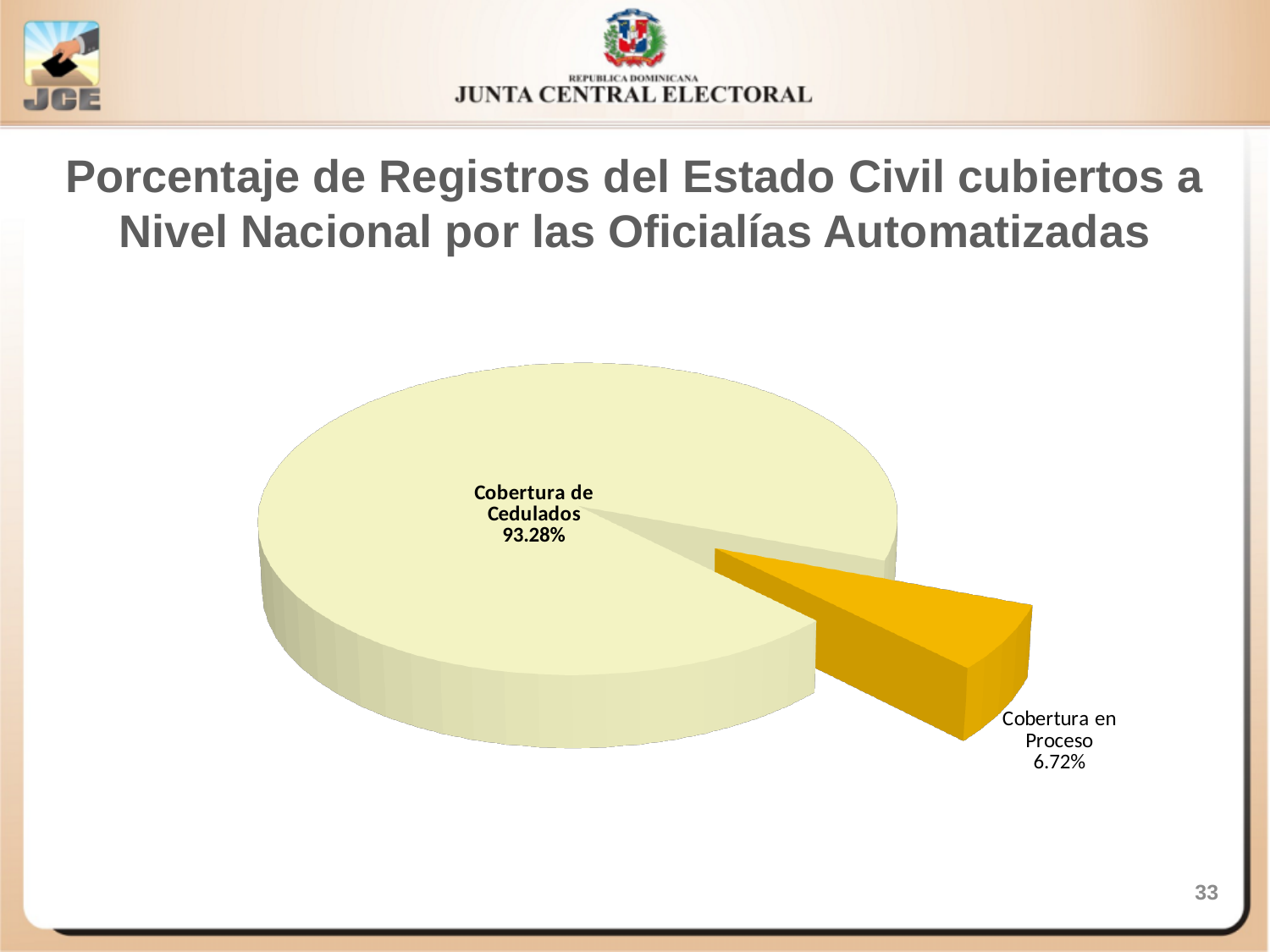
What is the title of the slide containing the pie chart? Porcentaje de Registros del Estado Civil cubiertos a Nivel Nacional por las Oficialías Automatizadas What colour is the Cobertura en Proceso slice? Orange/yellow What kind of chart is shown on the slide? Pie chart How many slices does the pie chart have? 2 What is the difference in percentage points between Cobertura de Cedulados and Cobertura en Proceso? 86.56 Is the value for Cobertura de Cedulados greater or less than 90%? greater Which is larger, Cobertura de Cedulados or Cobertura en Proceso? Cobertura de Cedulados Which slice of the pie is the largest? Cobertura de Cedulados What percentage is shown for Cobertura en Proceso? 6.72% What percentage is shown for Cobertura de Cedulados? 93.28% Which slice of the pie is the smallest? Cobertura en Proceso What share of the pie does Cobertura en Proceso represent? 6.72%